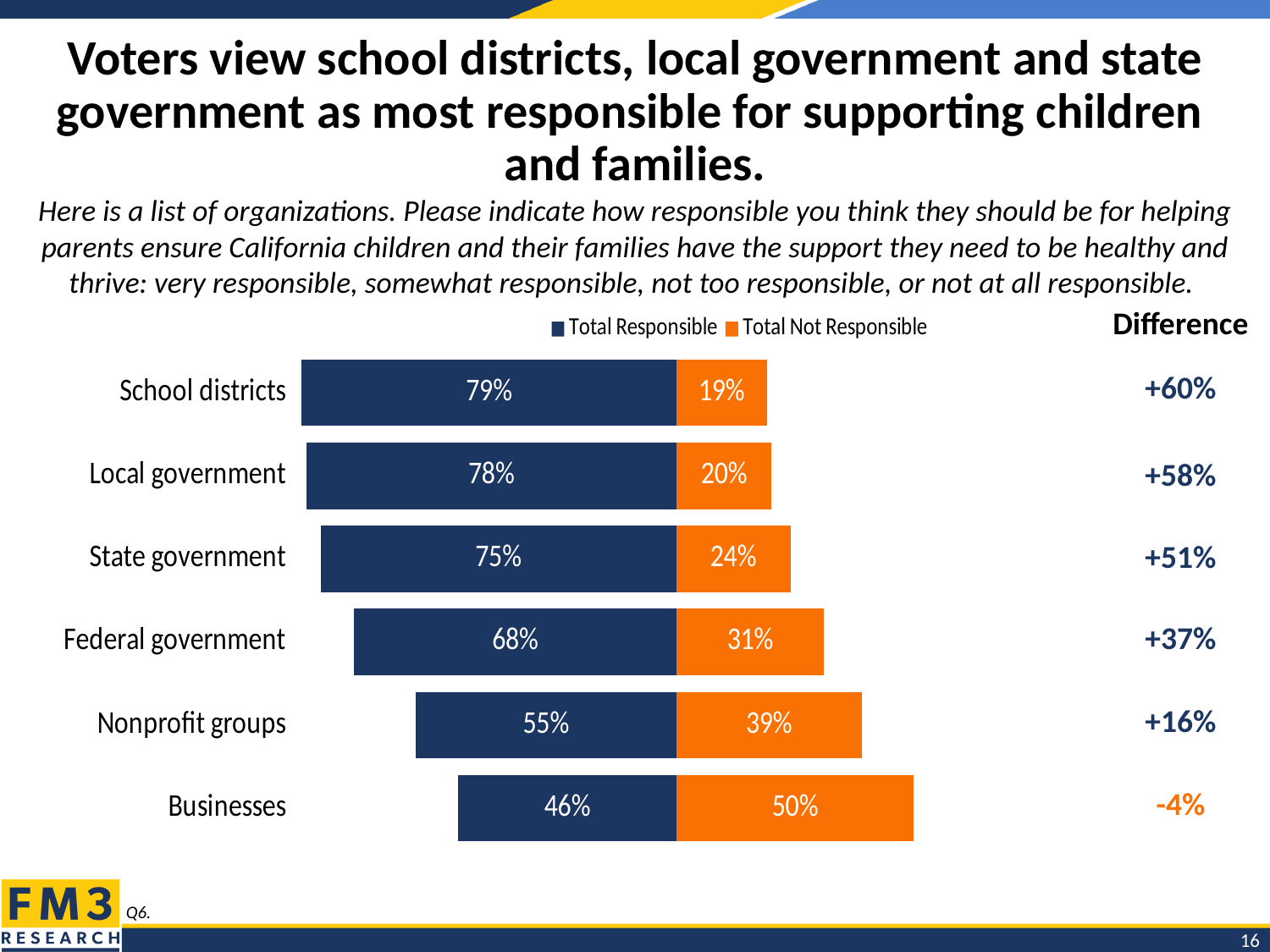
What is the Total Responsible value for Nonprofit groups? 55% Which is larger for Businesses: Total Responsible or Total Not Responsible? Total Not Responsible What is the Total Not Responsible value for Businesses? 50% Which organization has the highest Total Responsible value? School districts What colour represents the Total Not Responsible series? Orange What is the difference between the Total Responsible and Total Not Responsible values for Federal government? 37% How many series does the legend list? 2 What is the Difference value shown for State government? +51% Which organization has the lowest Total Responsible value? Businesses What kind of chart is shown on the slide? Bar chart How many organizations are shown in the chart? 6 What percentage of voters say school districts are responsible (Total Responsible)? 79%